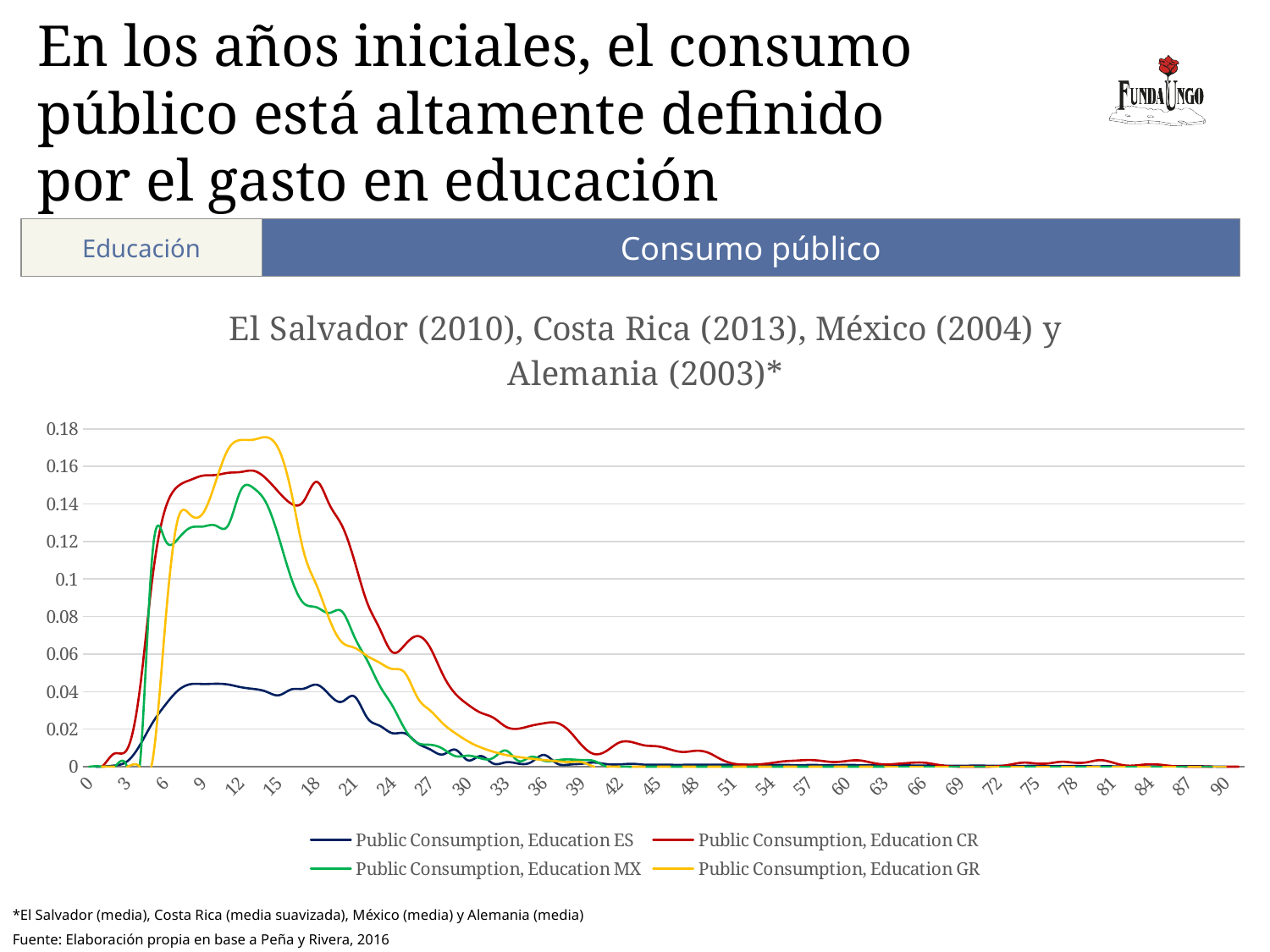
At age 24, is the value for Public Consumption, Education MX greater or less than 0.08? less What is the title of the chart? El Salvador (2010), Costa Rica (2013), México (2004) y Alemania (2003)* Is the peak value of the Public Consumption, Education GR series greater or less than 0.16? greater Do the values of the Public Consumption, Education CR series rise or fall between age 18 and age 30? fall At age 9, which is larger: the value for Public Consumption, Education CR or Public Consumption, Education ES? Public Consumption, Education CR How many series does the legend list? 4 Which series has the lowest peak value on the chart? Public Consumption, Education ES What kind of chart is shown on the slide? line chart What is the highest value shown on the vertical axis? 0.18 Is the peak value of the Public Consumption, Education CR series greater or less than 0.14? greater Which series reaches the highest peak value on the chart? Public Consumption, Education GR